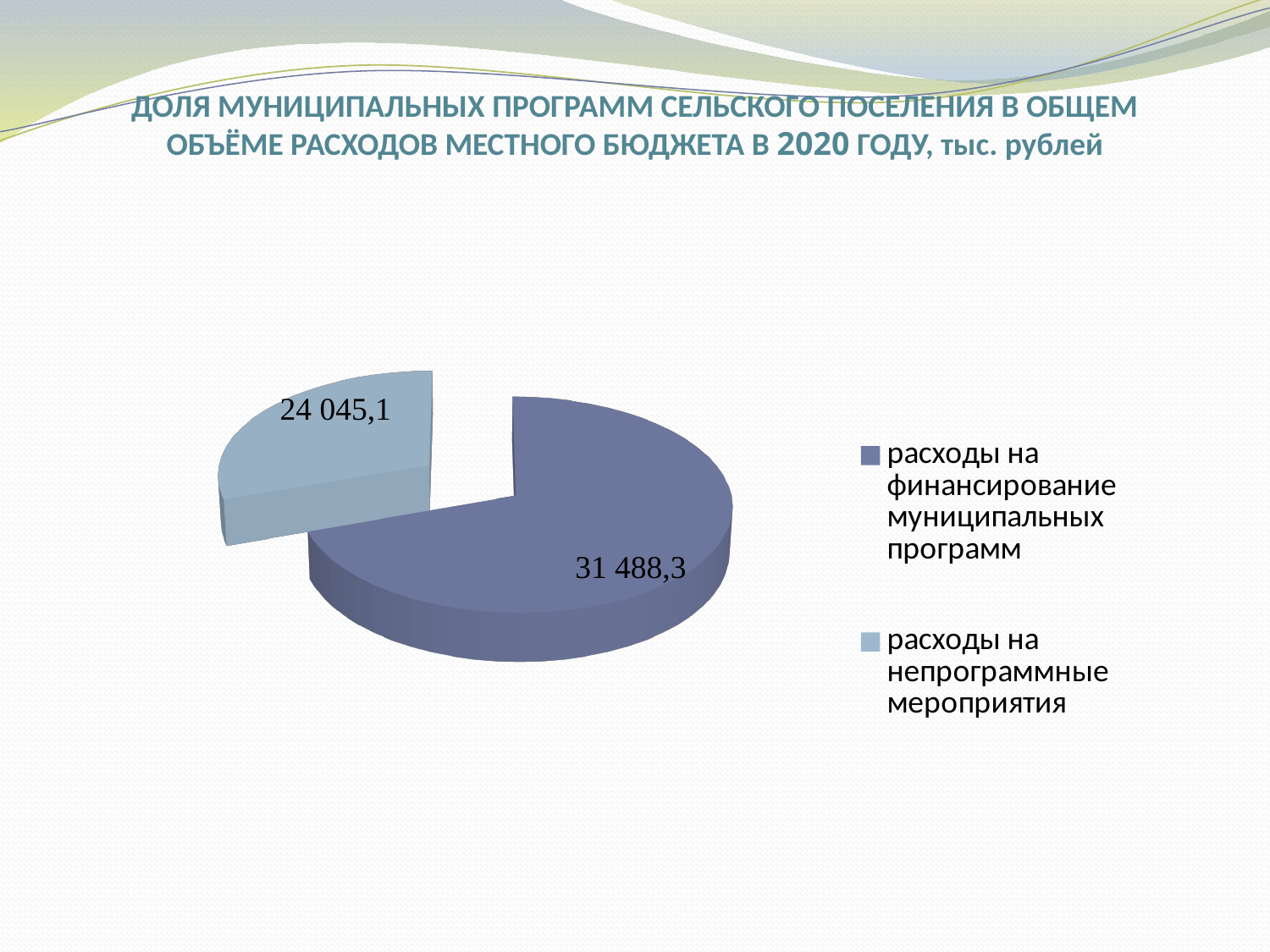
What is the difference between the value for расходы на финансирование муниципальных программ and the value for расходы на непрограммные мероприятия? 7 443,2 Which category has the largest slice of the pie? расходы на финансирование муниципальных программ Which is larger: расходы на финансирование муниципальных программ or расходы на непрограммные мероприятия? расходы на финансирование муниципальных программ How many entries does the legend list? 2 Which category has the smallest slice of the pie? расходы на непрограммные мероприятия What kind of chart is shown on the slide? pie chart What is the value for расходы на непрограммные мероприятия? 24 045,1 How many slices does the pie chart have? 2 What is the total of the two values shown on the pie chart? 55 533,4 What is the value for расходы на финансирование муниципальных программ? 31 488,3 What colour is the slice for расходы на непрограммные мероприятия? light blue